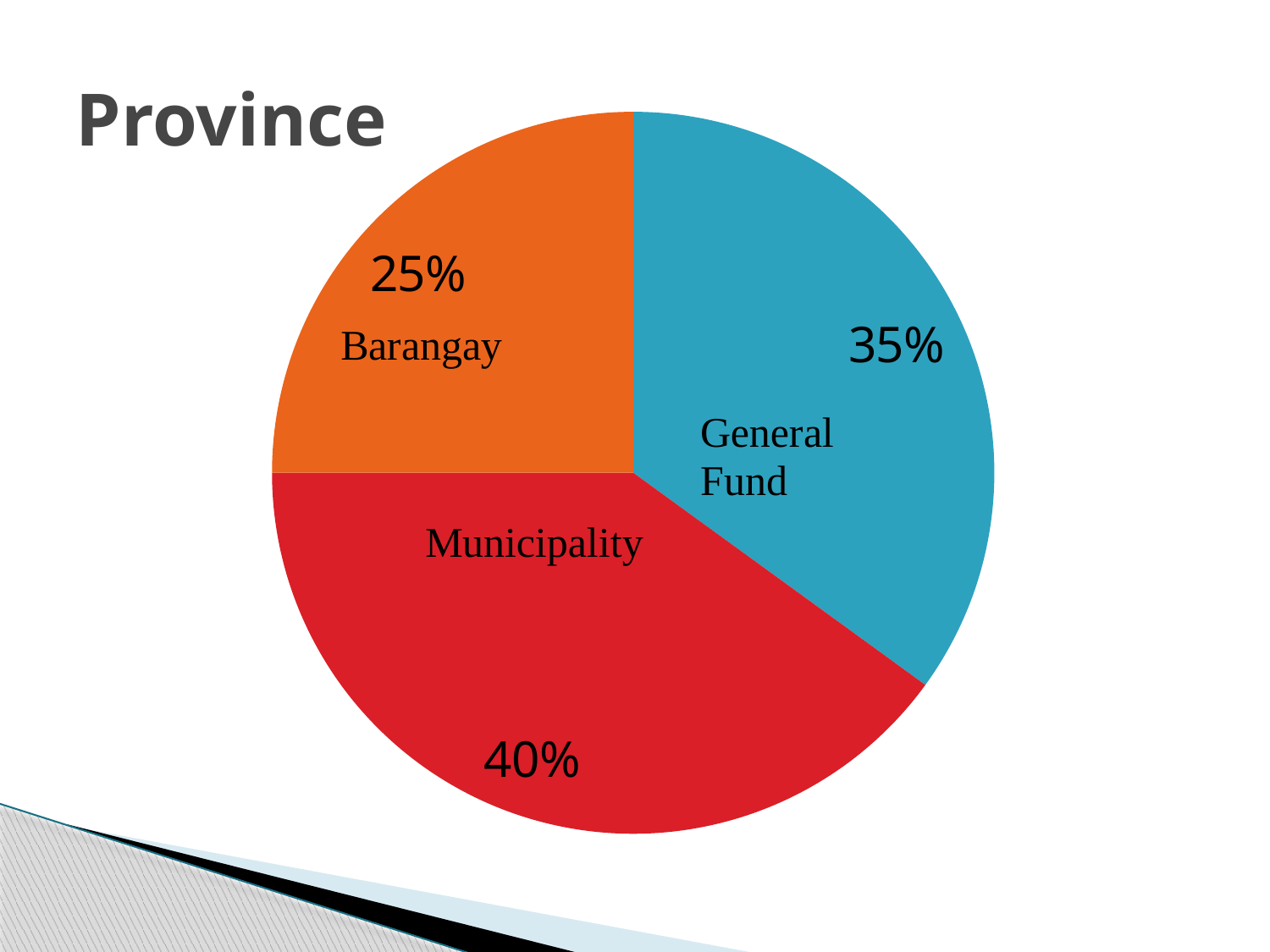
How many slices does the pie chart have? 3 Which slice is the smallest? Barangay What kind of chart is shown on the slide? pie chart What is the title shown on the slide above the chart? Province What share of the pie does General Fund have? 35% What share of the pie does Municipality have? 40% Which is larger, the General Fund slice or the Municipality slice? Municipality What is the difference between the General Fund share and the Barangay share? 10% What share of the pie does Barangay have? 25% Which slice is the largest? Municipality What colour is the Municipality slice? red What is the difference between the Municipality share and the Barangay share? 15%